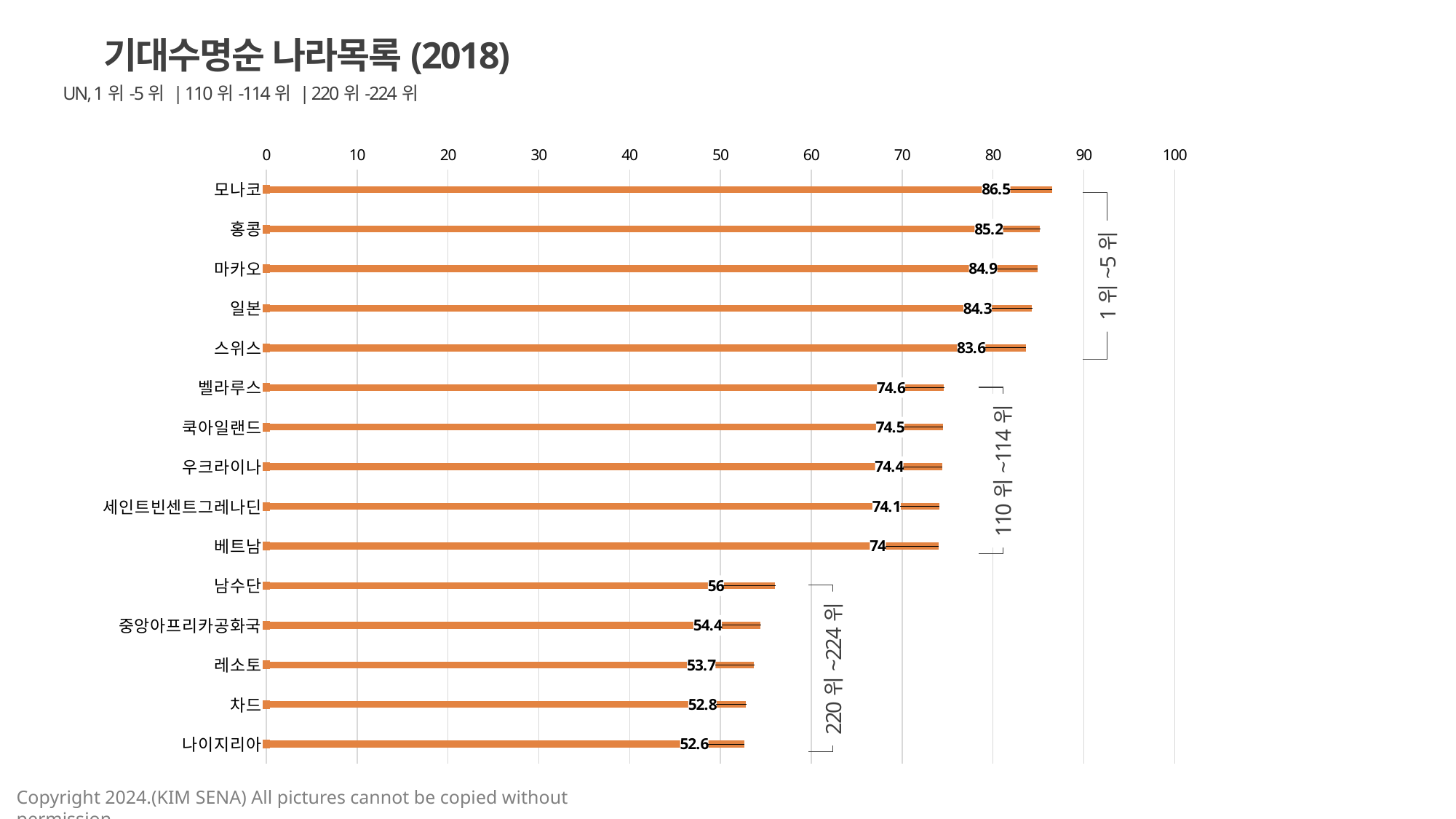
What is the value shown for 나이지리아? 52.6 What is the value shown for 베트남? 74 What is the title of the chart? 기대수명순 나라목록 (2018) How many countries are shown on the chart? 15 What kind of chart is shown on the slide? bar chart What is the difference between the values for 모나코 and 나이지리아? 33.9 What is the difference between the values for 일본 and 스위스? 0.7 Is the value for 남수단 greater or less than 50? greater Which country has the lowest value on the chart? 나이지리아 Which has a larger value, 홍콩 or 벨라루스? 홍콩 Which country has the highest value on the chart? 모나코 What is the life expectancy value shown for 모나코? 86.5